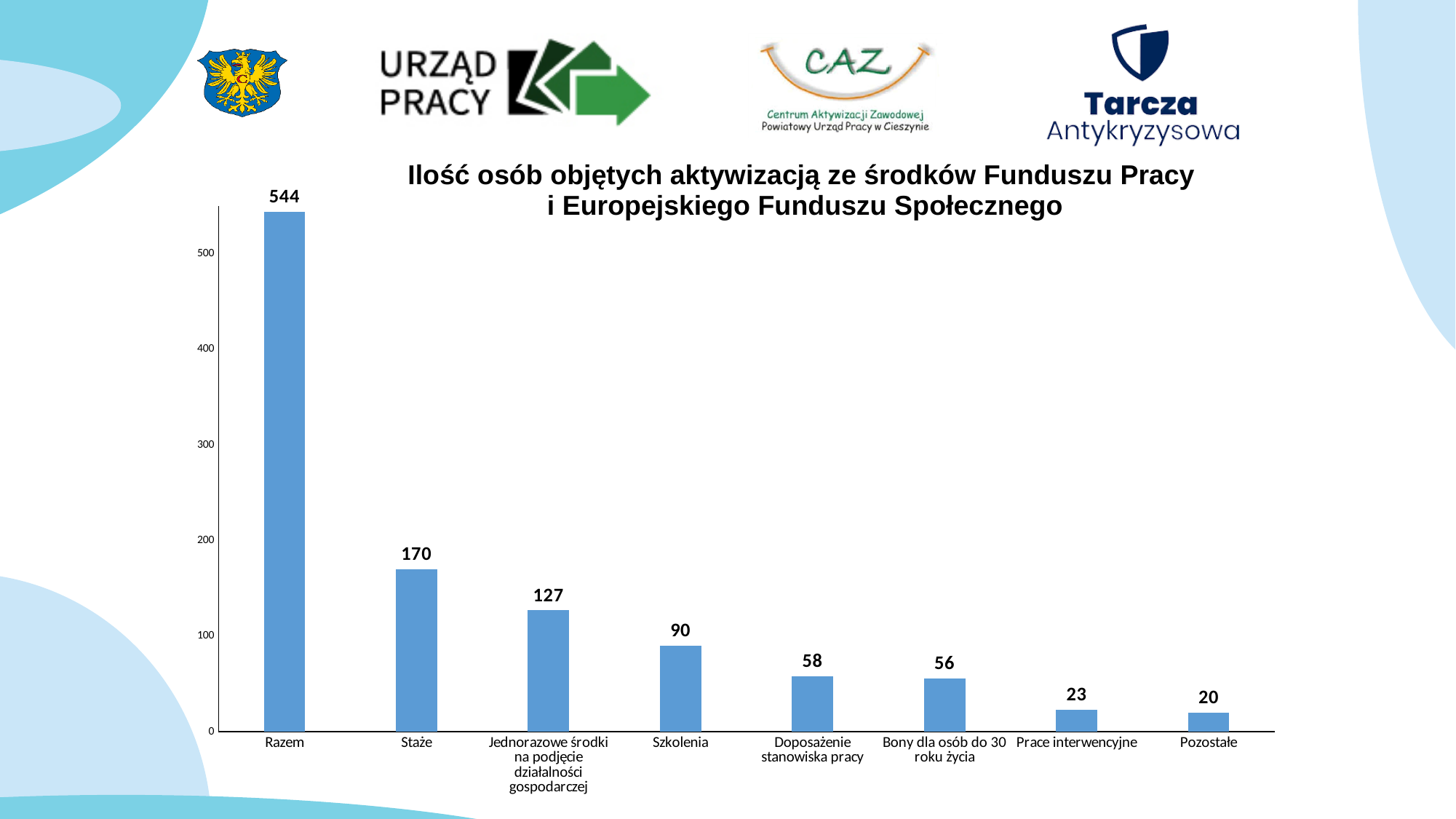
Which category has the highest value? Razem Which category has the lowest value? Pozostałe What kind of chart is shown on the slide? bar chart What is the difference between the values for Staże and Jednorazowe środki na podjęcie działalności gospodarczej? 43 What is the value for Szkolenia? 90 Is the value for Razem greater or less than 500? greater What is the value for Staże? 170 What is the value for Prace interwencyjne? 23 What is the value for Doposażenie stanowiska pracy? 58 How many categories are shown on the x axis? 8 Which is larger, the value for Szkolenia or the value for Bony dla osób do 30 roku życia? Szkolenia What is the title of the chart? Ilość osób objętych aktywizacją ze środków Funduszu Pracy i Europejskiego Funduszu Społecznego